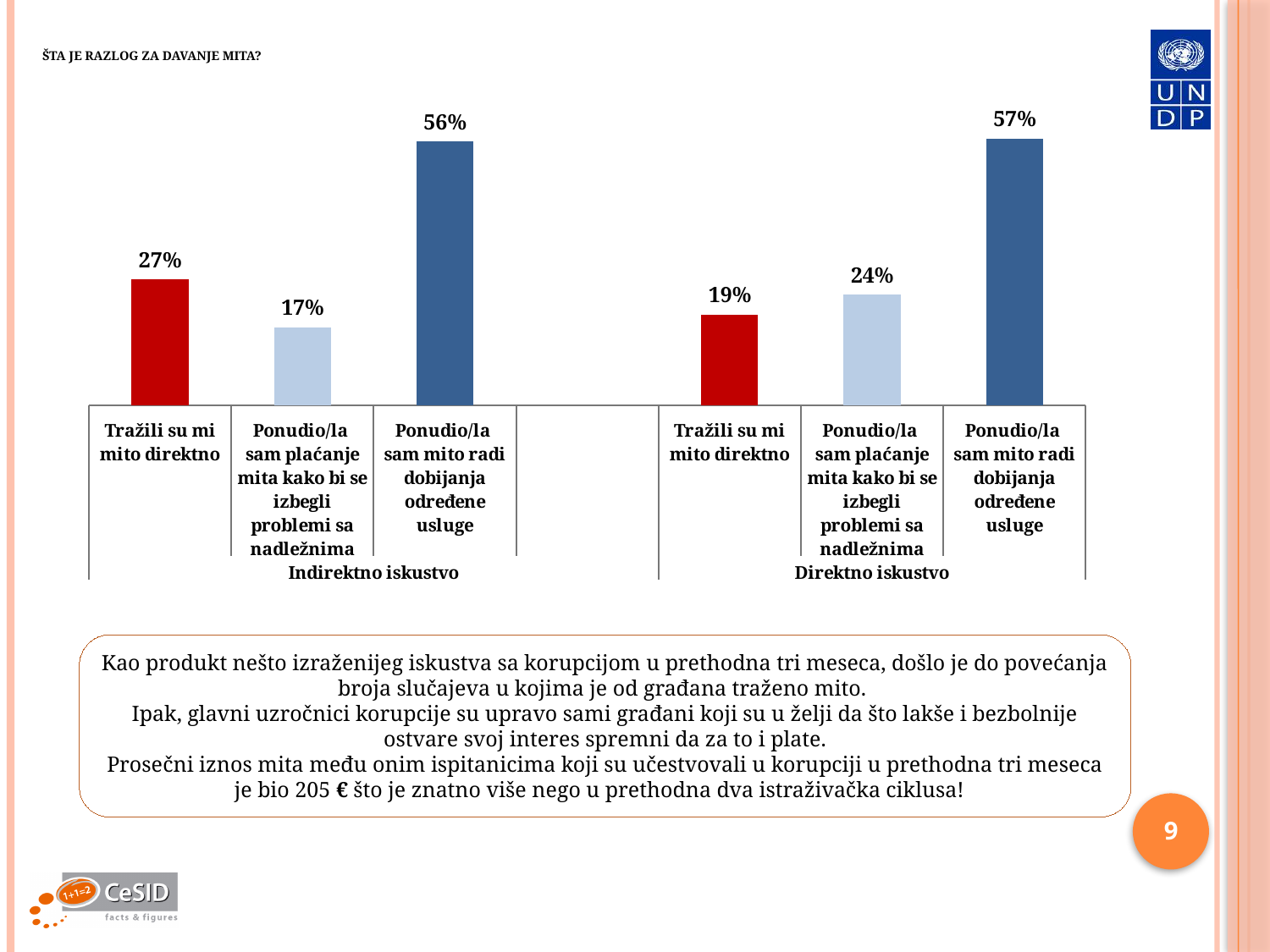
How many bars are plotted in the chart in total? 6 Which category has the lowest value in the "Direktno iskustvo" group? Tražili su mi mito direktno What type of chart is shown on the slide? bar chart What is the difference between the "Ponudio/la sam plaćanje mita kako bi se izbegli problemi sa nadležnima" values in the "Direktno iskustvo" and "Indirektno iskustvo" groups? 7% What is the value for "Ponudio/la sam mito radi dobijanja određene usluge" in the "Direktno iskustvo" group? 57% Which is larger: "Tražili su mi mito direktno" in the "Indirektno iskustvo" group or in the "Direktno iskustvo" group? Indirektno iskustvo What is the value for "Tražili su mi mito direktno" in the "Indirektno iskustvo" group? 27% What is the value for "Tražili su mi mito direktno" in the "Direktno iskustvo" group? 19% What is the title of the chart? ŠTA JE RAZLOG ZA DAVANJE MITA? What is the difference between "Ponudio/la sam mito radi dobijanja određene usluge" and "Tražili su mi mito direktno" in the "Indirektno iskustvo" group? 29% What is the value for "Ponudio/la sam plaćanje mita kako bi se izbegli problemi sa nadležnima" in the "Indirektno iskustvo" group? 17% Which category has the highest value in the "Indirektno iskustvo" group? Ponudio/la sam mito radi dobijanja određene usluge